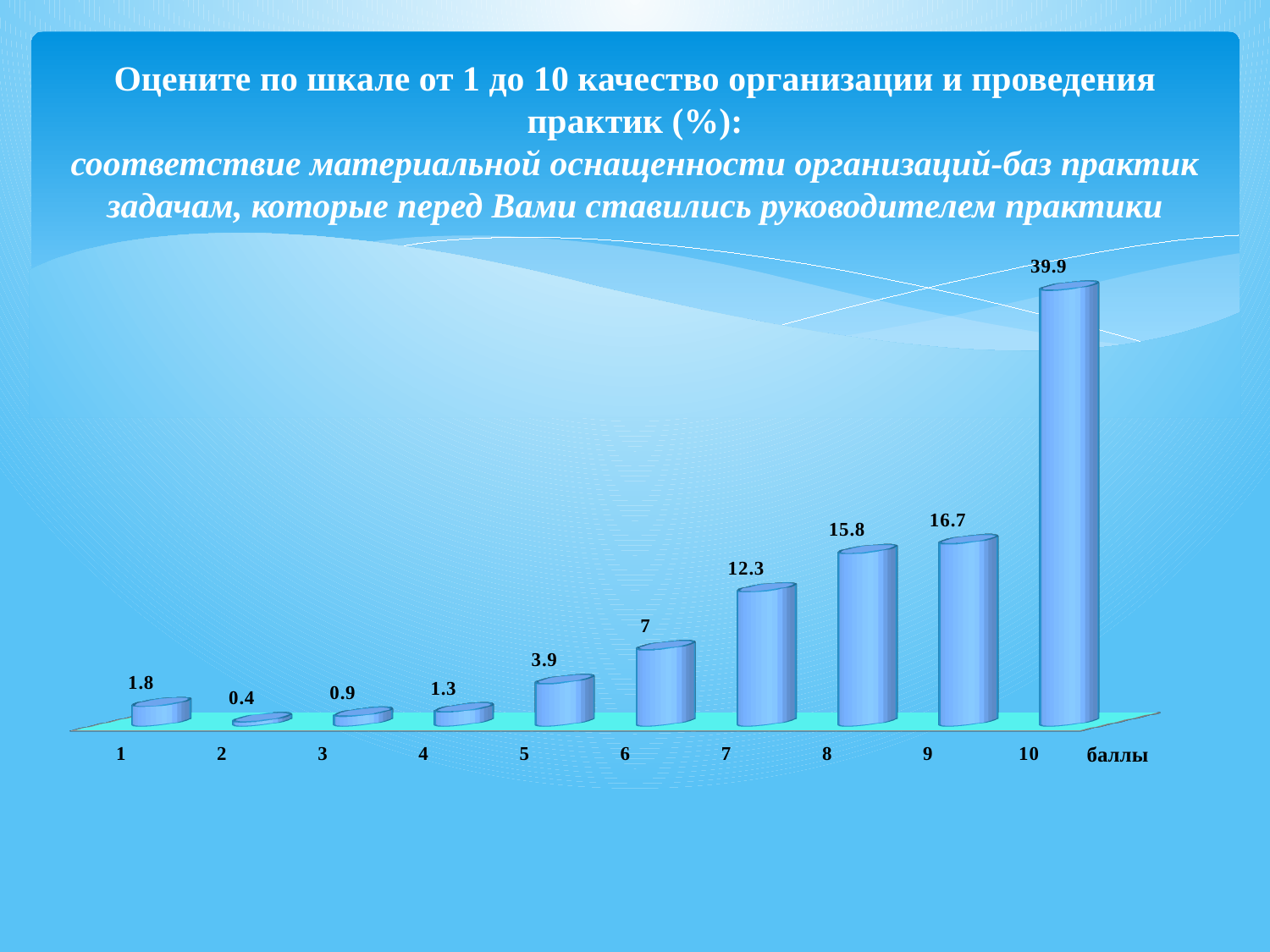
What is the value for score 1? 1.8 What is the difference between the values for score 10 and score 9? 23.2 What is the label of the x axis? баллы What kind of chart is shown on the slide? bar chart Which score has the lowest value? 2 What is the difference between the values for score 9 and score 8? 0.9 Which score has the highest value? 10 How many score categories are shown on the x axis? 10 Do the values generally rise or fall from score 2 to score 10? rise Which is larger, the value for score 5 or the value for score 6? score 6 What is the value for score 7? 12.3 What is the value for score 10? 39.9